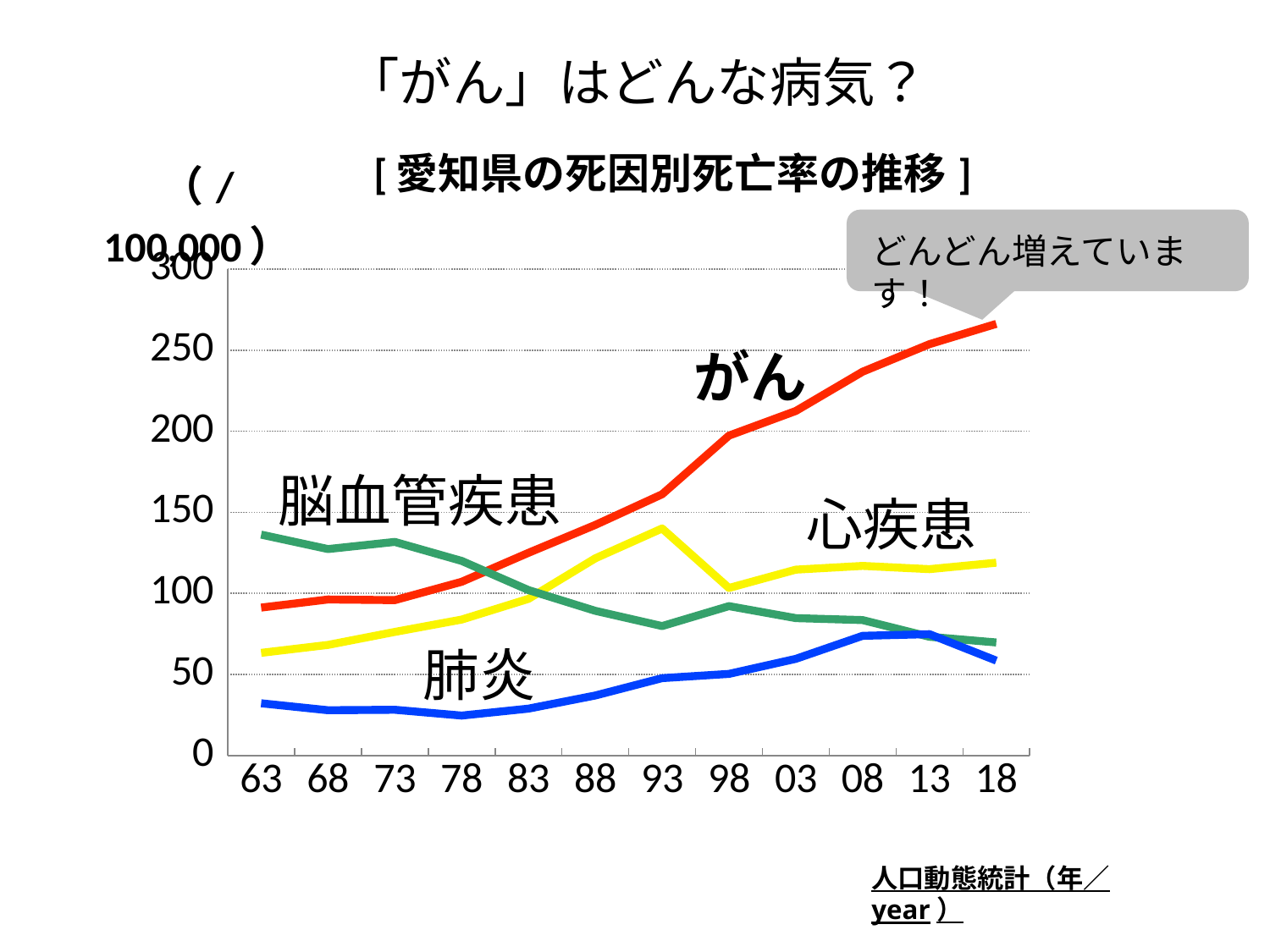
Which series has the highest value at 63? 脳血管疾患 Is the value for がん at 18 greater or less than 250? greater What is the title of the chart? 愛知県の死因別死亡率の推移 Does the value for 脳血管疾患 rise or fall overall from 63 to 18? fall What kind of chart is shown on the slide? line chart Is the value for 肺炎 at 63 greater or less than 50? less Which series has the highest value at 18? がん At 63, which is larger: 脳血管疾患 or がん? 脳血管疾患 Which series has the lowest value at 18? 肺炎 How many lines (series) are plotted on the chart? 4 Does the value for がん rise or fall from 63 to 18? rise How many year points are shown along the x axis? 12